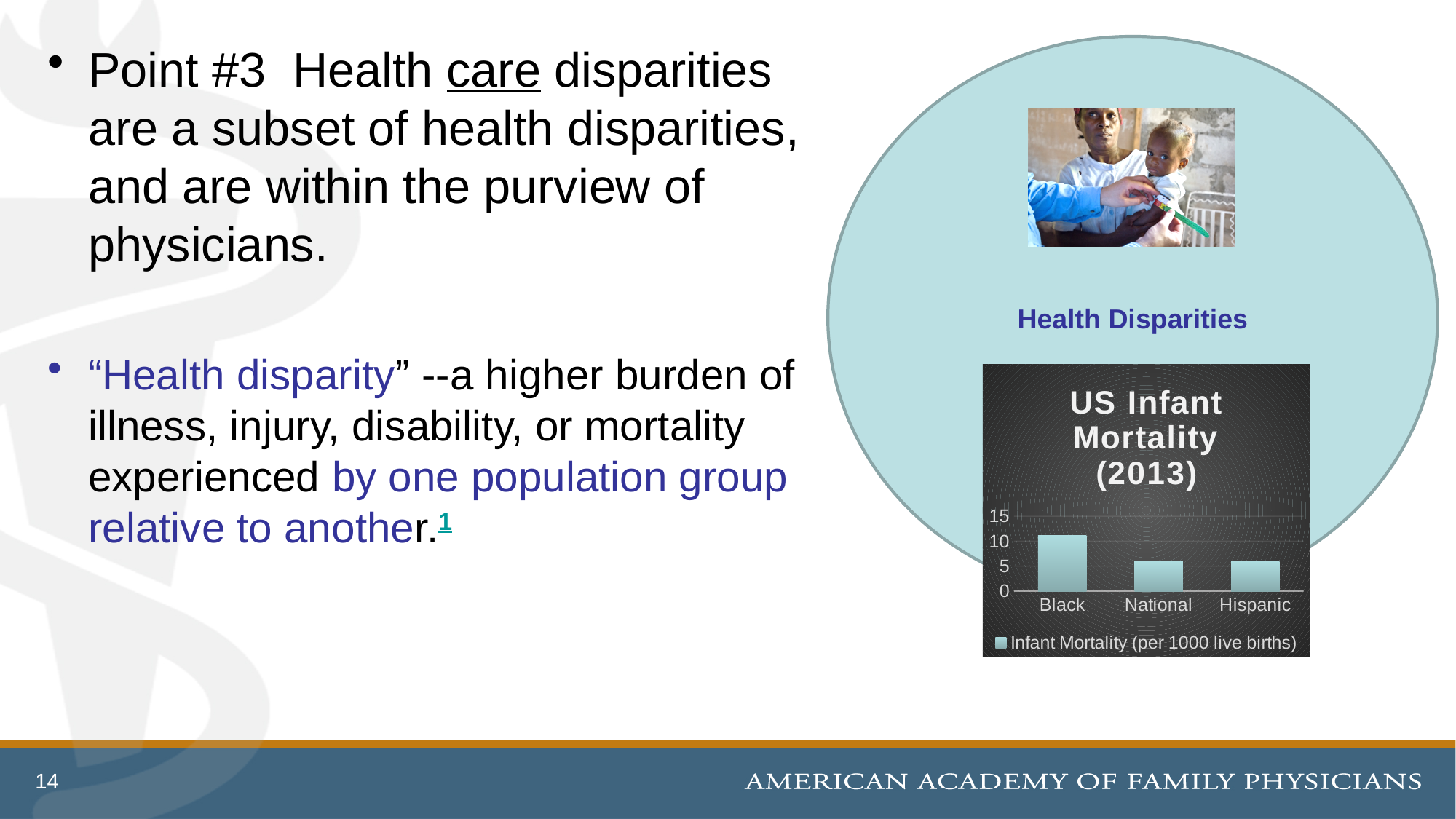
In the US Infant Mortality chart, is the value for Black greater or less than 15? less In the US Infant Mortality chart, which is larger, the value for Black or the value for Hispanic? Black In the US Infant Mortality chart, is the value for Black greater or less than 10? greater In the US Infant Mortality chart, is the value for Hispanic greater or less than 10? less How many categories are shown on the x axis of the US Infant Mortality chart? 3 How many series does the legend of the US Infant Mortality chart list? 1 What is the legend entry of the US Infant Mortality chart? Infant Mortality (per 1000 live births) Which category has the highest infant mortality in the US Infant Mortality chart? Black In the US Infant Mortality chart, which is larger, the value for Black or the value for National? Black What type of chart is shown under the title "US Infant Mortality (2013)"? bar chart What is the title of the chart on the slide? US Infant Mortality (2013)